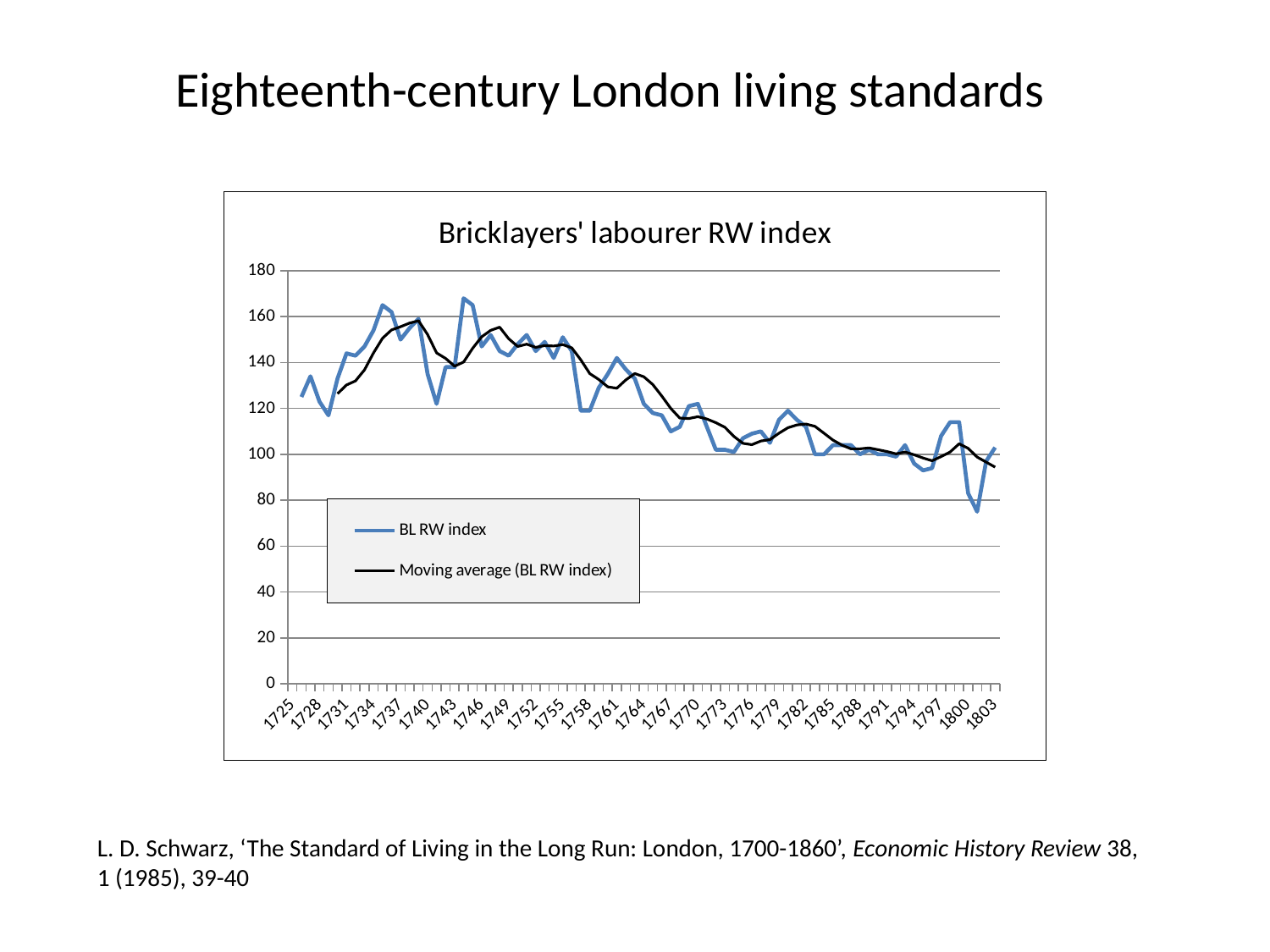
Is the BL RW index value for 1758 greater or less than 140? less Overall, does the BL RW index rise or fall between the 1740s and 1800? fall Which series is drawn in black? Moving average (BL RW index) Is the BL RW index value for 1800 greater or less than 100? less What kind of chart is shown on the slide? line chart Is the BL RW index value for 1737 greater or less than 140? greater How many series does the chart's legend list? 2 What is the title of the chart? Bricklayers' labourer RW index Which year has the lowest BL RW index value on the chart? 1801